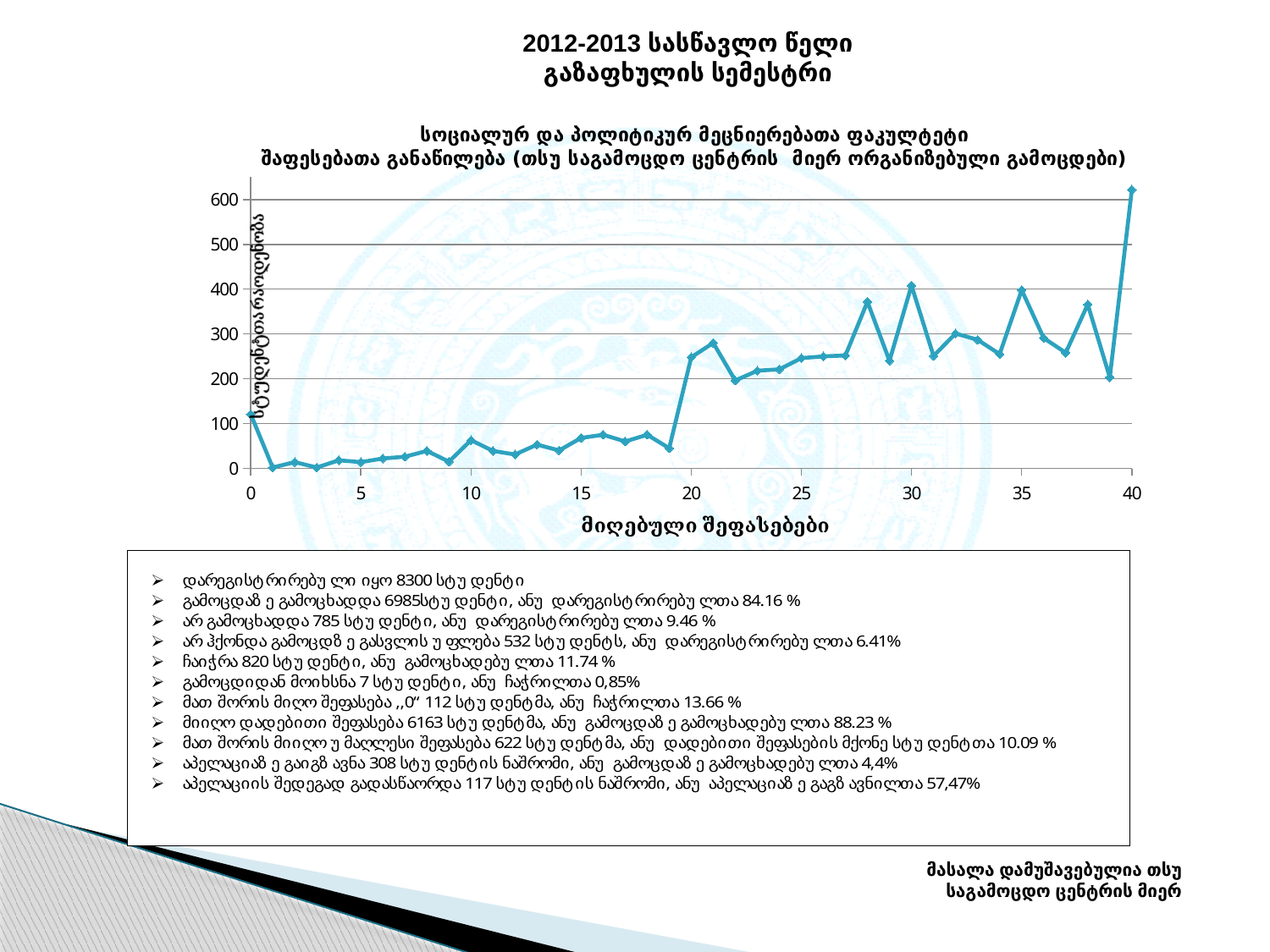
Do the values generally rise or fall as x increases from 0 to 40? rise Which has the larger value, x = 10 or x = 20? x = 20 Is the value at x = 35 greater or less than 300? greater Is the value at x = 5 greater or less than 100? less What is the label of the x axis? მიღებული შეფასებები What kind of chart is shown on the slide? line chart Is the value at x = 30 greater or less than 300? greater Which has the larger value, x = 25 or x = 35? x = 35 At which x-axis value does the line reach its highest point? 40